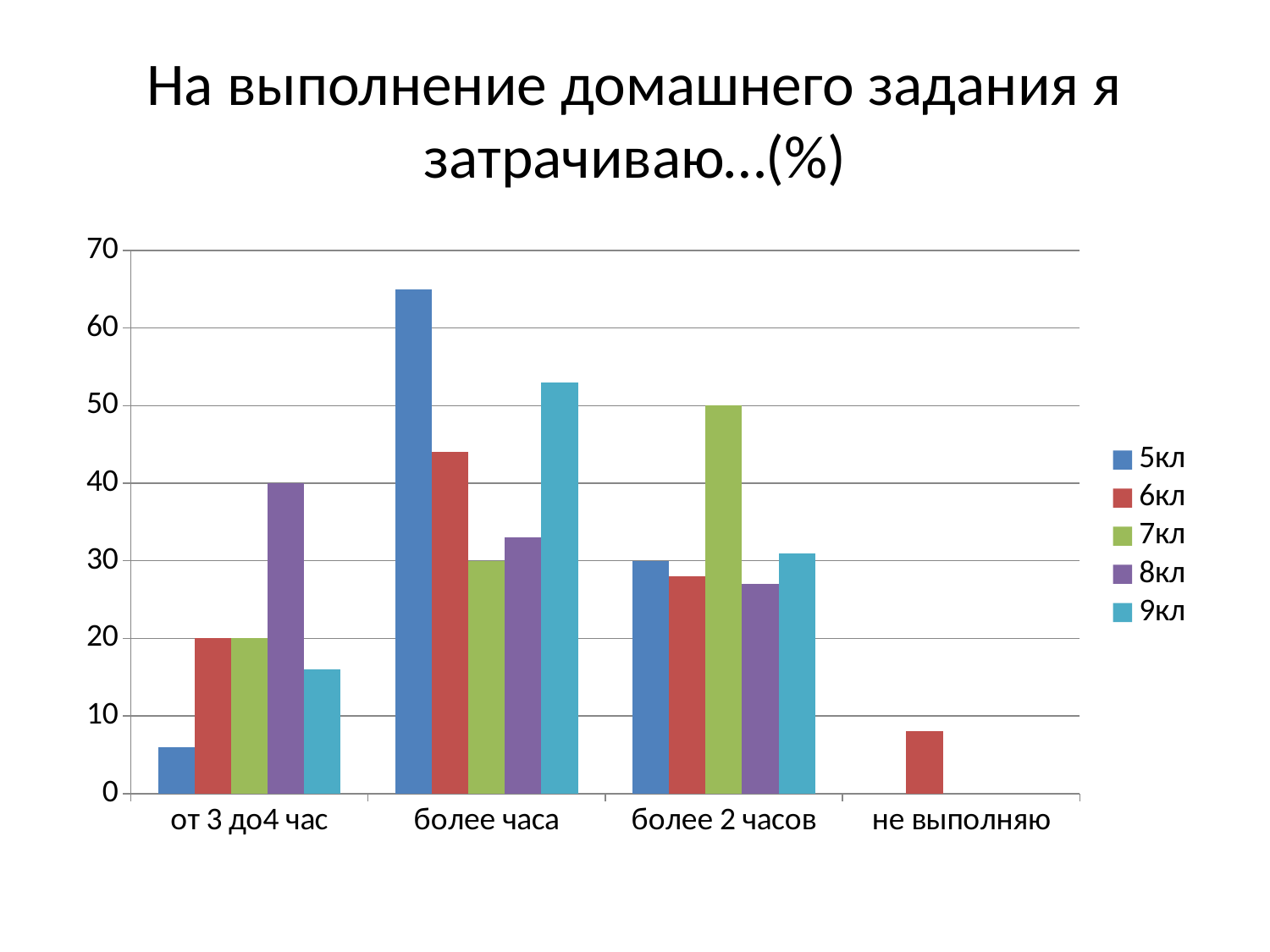
What is the value for 6кл in the category 'от 3 до4 час'? 20 Which series is the only one with a visible bar in the category 'не выполняю'? 6кл Is the value for 5кл in the category 'более часа' greater or less than 60? greater What is the value for 7кл in the category 'более часа'? 30 How many categories are shown on the x axis? 4 How many series does the legend list? 5 What kind of chart is shown on the slide? bar chart Which is larger in the category 'более 2 часов': the value for 5кл or the value for 8кл? 5кл What is the value for 7кл in the category 'более 2 часов'? 50 What is the value for 8кл in the category 'от 3 до4 час'? 40 Which series has the lowest value in the category 'от 3 до4 час'? 5кл Which series has the highest value in the category 'более часа'? 5кл